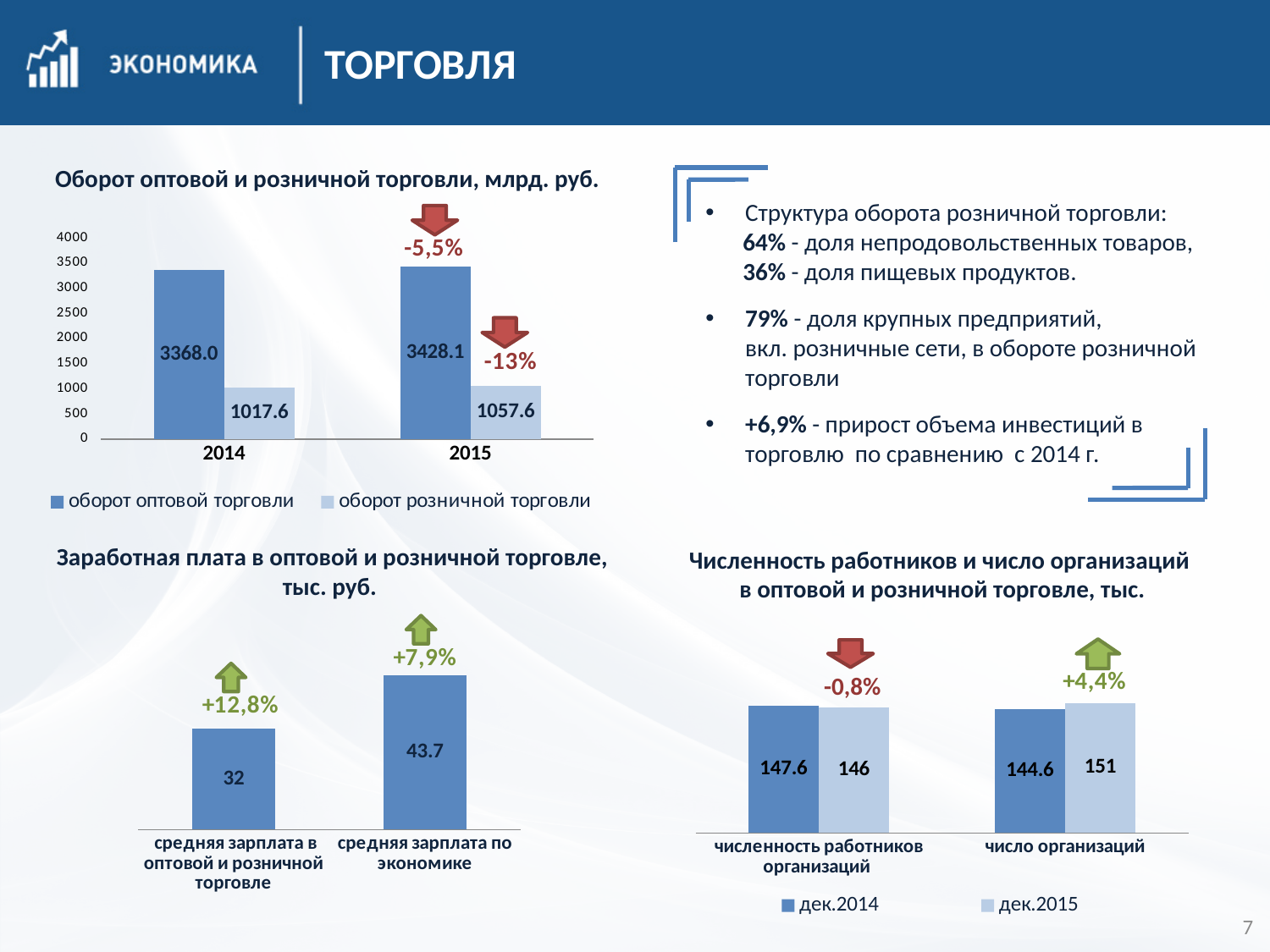
In the chart 'Численность работников и число организаций в оптовой и розничной торговле, тыс.', how many categories are shown on the x axis? 2 In the chart 'Заработная плата в оптовой и розничной торговле, тыс. руб.', which category has the lowest value? средняя зарплата в оптовой и розничной торговле What kind of chart is 'Заработная плата в оптовой и розничной торговле, тыс. руб.'? bar chart In the chart 'Оборот оптовой и розничной торговли, млрд. руб.', is the value of оборот оптовой торговли for 2014 greater or less than 3000? greater In the chart 'Оборот оптовой и розничной торговли, млрд. руб.', what is the value of оборот оптовой торговли for 2015? 3428.1 In the chart 'Заработная плата в оптовой и розничной торговле, тыс. руб.', what is the value for средняя зарплата по экономике? 43.7 In the chart 'Численность работников и число организаций в оптовой и розничной торговле, тыс.', which is larger for численность работников организаций: дек.2014 or дек.2015? дек.2014 In the chart 'Оборот оптовой и розничной торговли, млрд. руб.', what is the value of оборот розничной торговли for 2014? 1017.6 In the chart 'Оборот оптовой и розничной торговли, млрд. руб.', what is the difference between оборот оптовой торговли in 2015 and in 2014? 60.1 In the chart 'Оборот оптовой и розничной торговли, млрд. руб.', how many series does the legend list? 2 In the chart 'Численность работников и число организаций в оптовой и розничной торговле, тыс.', what is the value of число организаций for дек.2015? 151 In the chart 'Заработная плата в оптовой и розничной торговле, тыс. руб.', what is the difference between средняя зарплата по экономике and средняя зарплата в оптовой и розничной торговле? 11.7